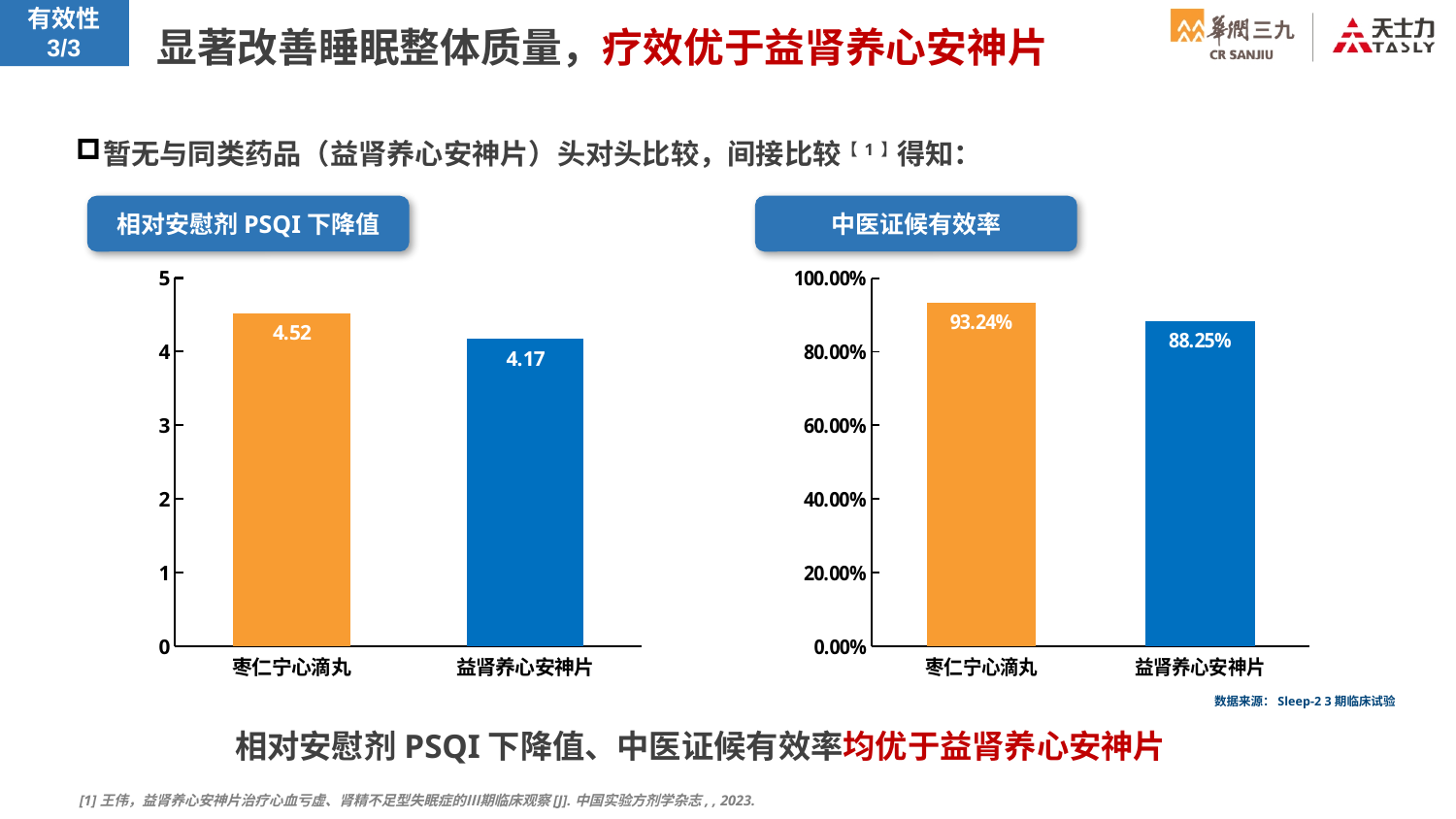
In the 相对安慰剂 PSQI 下降值 chart, what is the value for 枣仁宁心滴丸? 4.52 In the 相对安慰剂 PSQI 下降值 chart, what is the difference between the values for 枣仁宁心滴丸 and 益肾养心安神片? 0.35 In the 中医证候有效率 chart, which category has the lowest value? 益肾养心安神片 In the 相对安慰剂 PSQI 下降值 chart, is the value for 益肾养心安神片 greater or less than 4? greater In the 相对安慰剂 PSQI 下降值 chart, what is the value for 益肾养心安神片? 4.17 In the 相对安慰剂 PSQI 下降值 chart, which category has the highest value? 枣仁宁心滴丸 In the 中医证候有效率 chart, what is the value for 益肾养心安神片? 88.25% What kind of chart is the 相对安慰剂 PSQI 下降值 chart? bar chart In the 中医证候有效率 chart, what is the value for 枣仁宁心滴丸? 93.24% In the 中医证候有效率 chart, which is larger, the value for 枣仁宁心滴丸 or for 益肾养心安神片? 枣仁宁心滴丸 How many categories are shown in the 中医证候有效率 chart? 2 In the 中医证候有效率 chart, what is the difference between the values for 枣仁宁心滴丸 and 益肾养心安神片? 4.99%